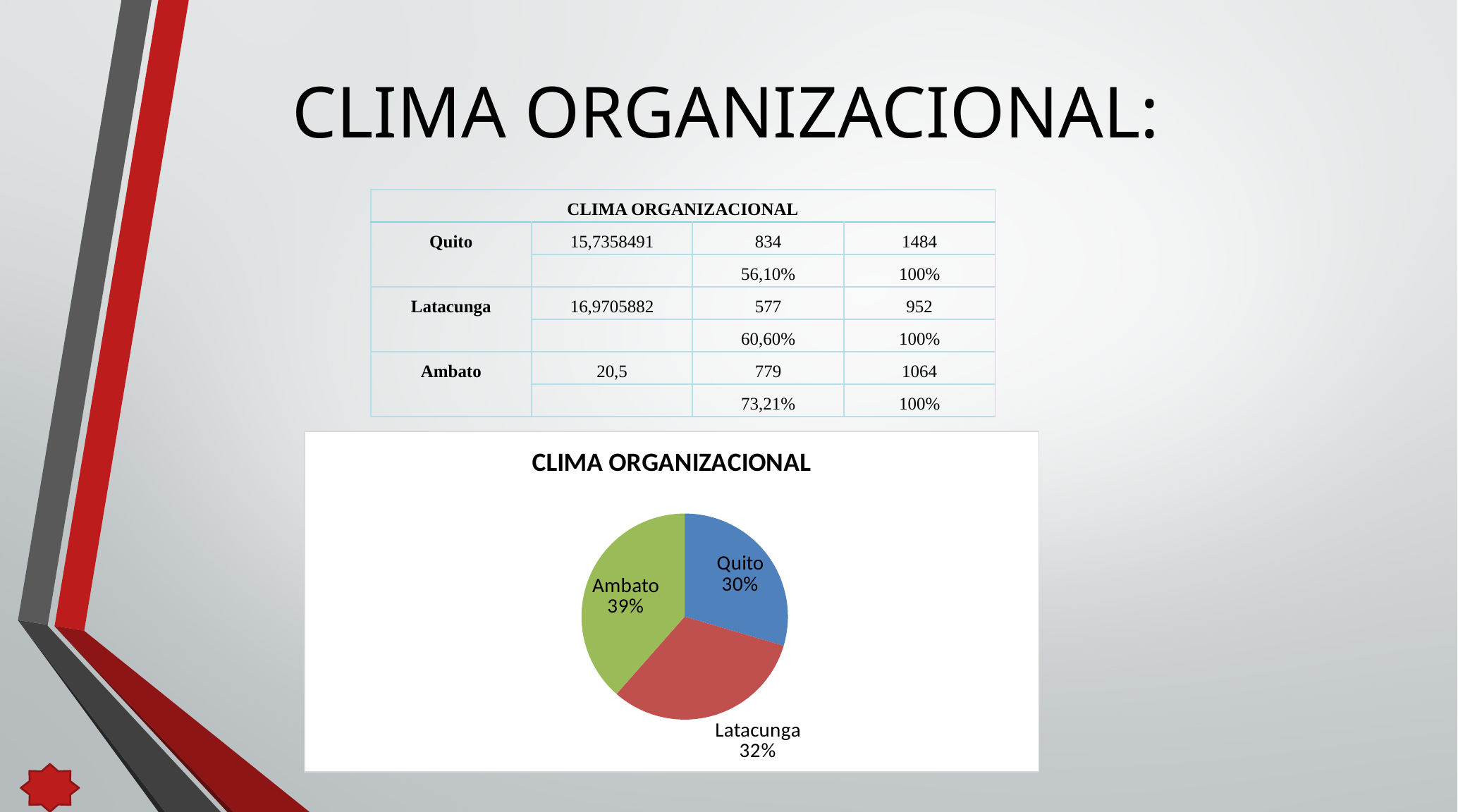
What share of the pie does Ambato represent? 39% What is the difference in percentage points between the Ambato slice and the Quito slice? 9% Which slice of the pie is the smallest? Quito What share of the pie does Quito represent? 30% What is the title of the chart? CLIMA ORGANIZACIONAL What is the difference in percentage points between the Latacunga slice and the Quito slice? 2% Which slice of the pie is the largest? Ambato What share of the pie does Latacunga represent? 32% What colour is the Ambato slice of the pie? green What type of chart is shown on the slide? pie chart Which slice is larger, Latacunga or Ambato? Ambato How many slices does the pie chart have? 3